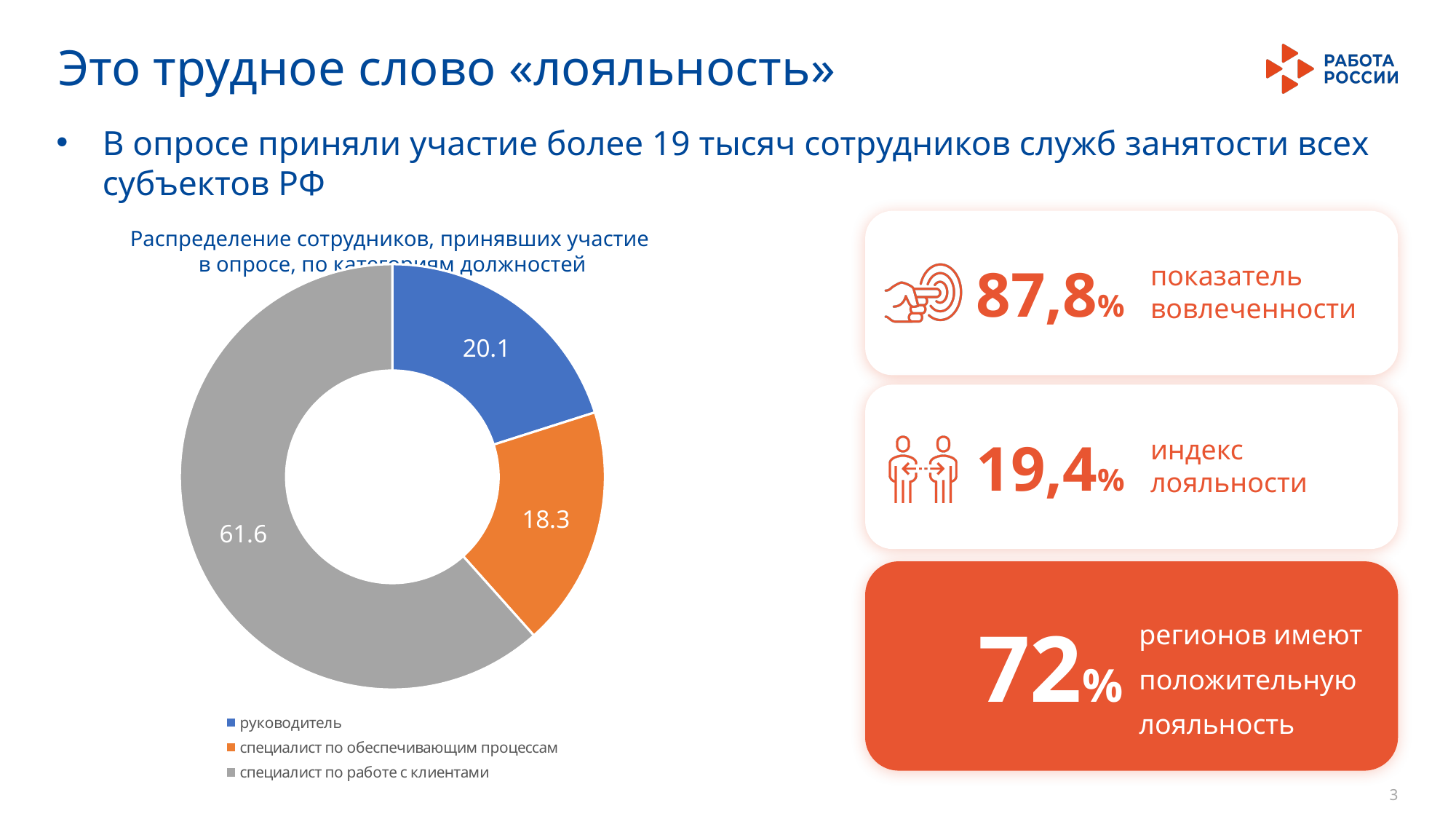
What is the title of the chart on the slide? Распределение сотрудников, принявших участие в опросе, по категориям должностей Which category has the smallest share in the doughnut chart? специалист по обеспечивающим процессам What kind of chart is shown on the slide? doughnut chart What is the difference between the values for руководитель and специалист по обеспечивающим процессам? 1.8 What is the difference between the values for специалист по работе с клиентами and руководитель? 41.5 What colour represents the руководитель category in the chart? blue Which category has the largest share in the doughnut chart? специалист по работе с клиентами What value is shown for специалист по обеспечивающим процессам in the chart? 18.3 Which is larger: the value for руководитель or for специалист по обеспечивающим процессам? руководитель How many categories does the doughnut chart show? 3 What value is shown for the руководитель category in the doughnut chart? 20.1 What value is shown for специалист по работе с клиентами in the chart? 61.6